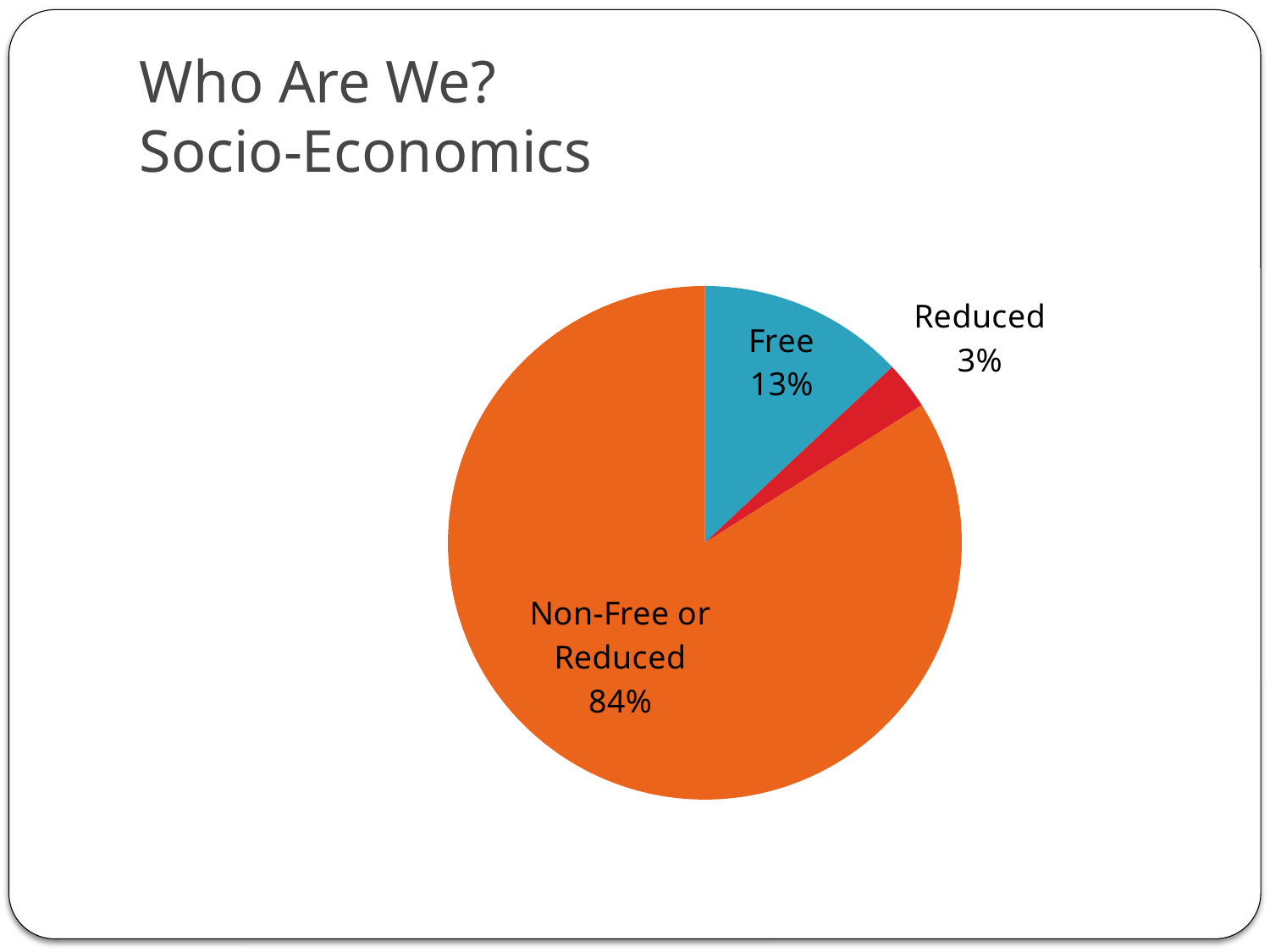
What colour is the Non-Free or Reduced slice? orange What percentage of the pie is labelled Reduced? 3% What is the difference in percentage points between the Non-Free or Reduced slice and the Free slice? 71 What percentage of the pie is labelled Non-Free or Reduced? 84% How many slices does the pie chart have? 3 What is the difference in percentage points between the Free slice and the Reduced slice? 10 Which slice of the pie is the smallest? Reduced Which slice of the pie is the largest? Non-Free or Reduced Which is larger, the Free slice or the Reduced slice? Free What is the combined share of the Free and Reduced slices? 16% What kind of chart is shown on the slide? pie chart What percentage of the pie is labelled Free? 13%